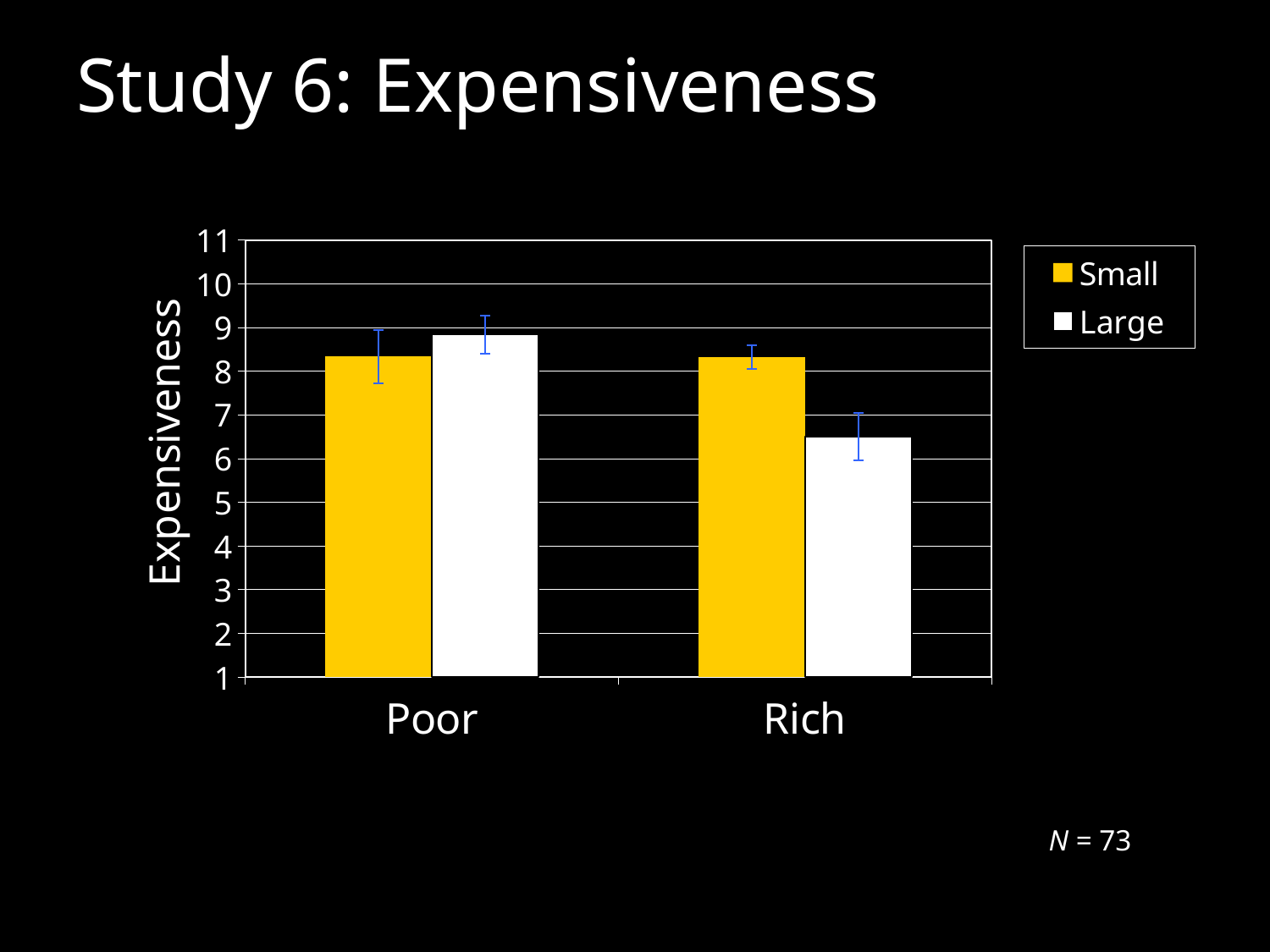
What is the label on the y axis? Expensiveness Is the value for Large in the Poor category greater or less than 8? greater Which bar is the lowest on the chart? Large for Rich Is the value for Large in the Rich category greater or less than 7? less What kind of chart is shown on the slide? bar chart Is the value for Small in the Rich category greater or less than 8? greater Which bar is the highest on the chart? Large for Poor In the Rich category, which series has the larger value, Small or Large? Small How many categories are shown on the x axis? 2 Which is larger: the Large bar for Poor or the Large bar for Rich? Poor Which series is shown in yellow in the legend? Small How many series does the legend list? 2